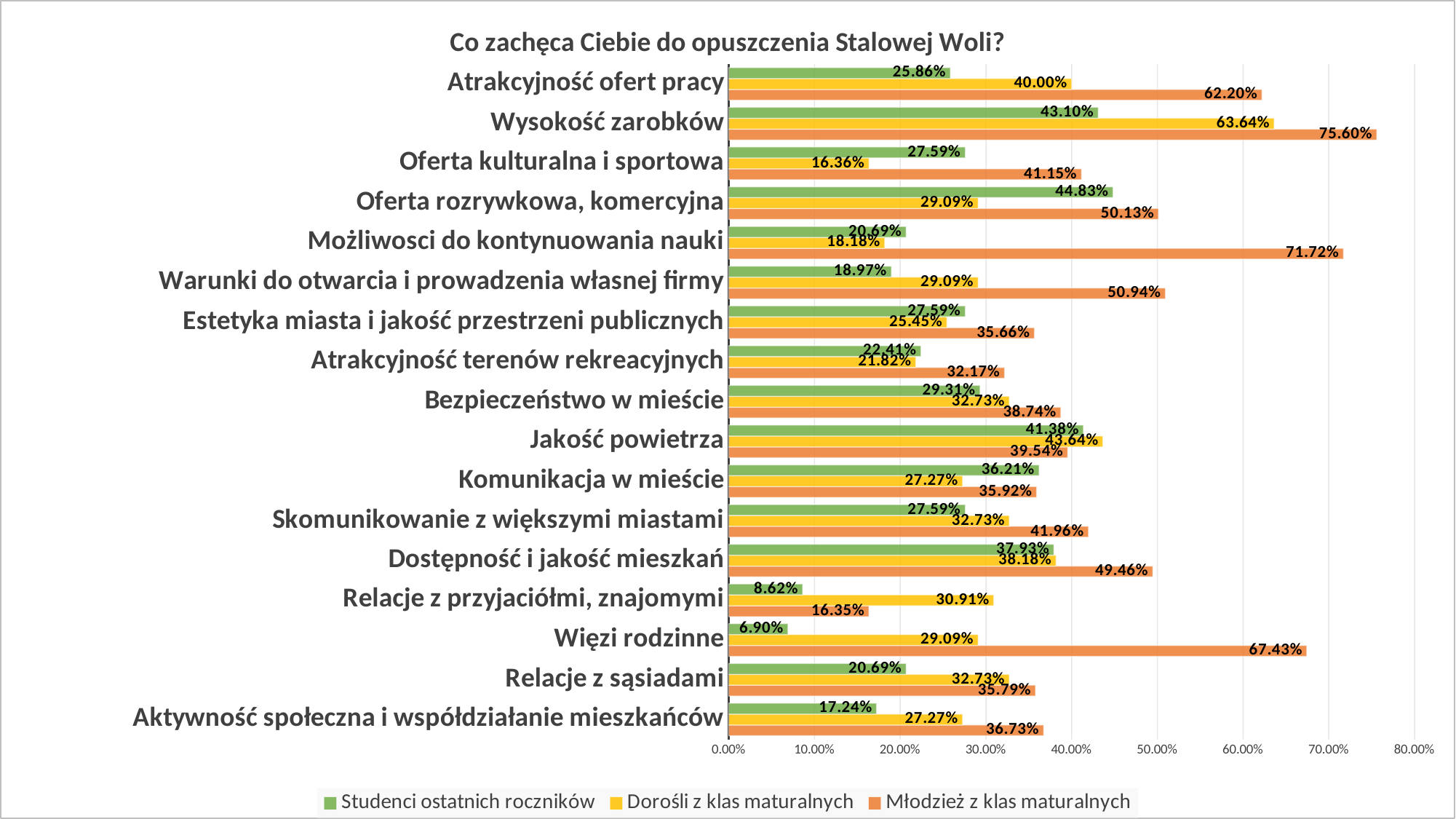
Which category has the highest value for Młodzież z klas maturalnych? Wysokość zarobków Which category has the lowest value for Studenci ostatnich roczników? Więzi rodzinne What is the value for Dorośli z klas maturalnych for Atrakcyjność ofert pracy? 40.00% How many series does the legend list? 3 What is the difference between the Młodzież z klas maturalnych and Studenci ostatnich roczników values for Wysokość zarobków? 32.50 percentage points What is the value for Młodzież z klas maturalnych for Wysokość zarobków? 75.60% What is the value for Młodzież z klas maturalnych for Możliwosci do kontynuowania nauki? 71.72% What kind of chart is shown on the slide? Bar chart How many categories are shown on the chart? 17 What is the title of the chart? Co zachęca Ciebie do opuszczenia Stalowej Woli? What is the value for Studenci ostatnich roczników for Relacje z przyjaciółmi, znajomymi? 8.62% For Relacje z przyjaciółmi, znajomymi, which series has the larger value: Dorośli z klas maturalnych or Młodzież z klas maturalnych? Dorośli z klas maturalnych